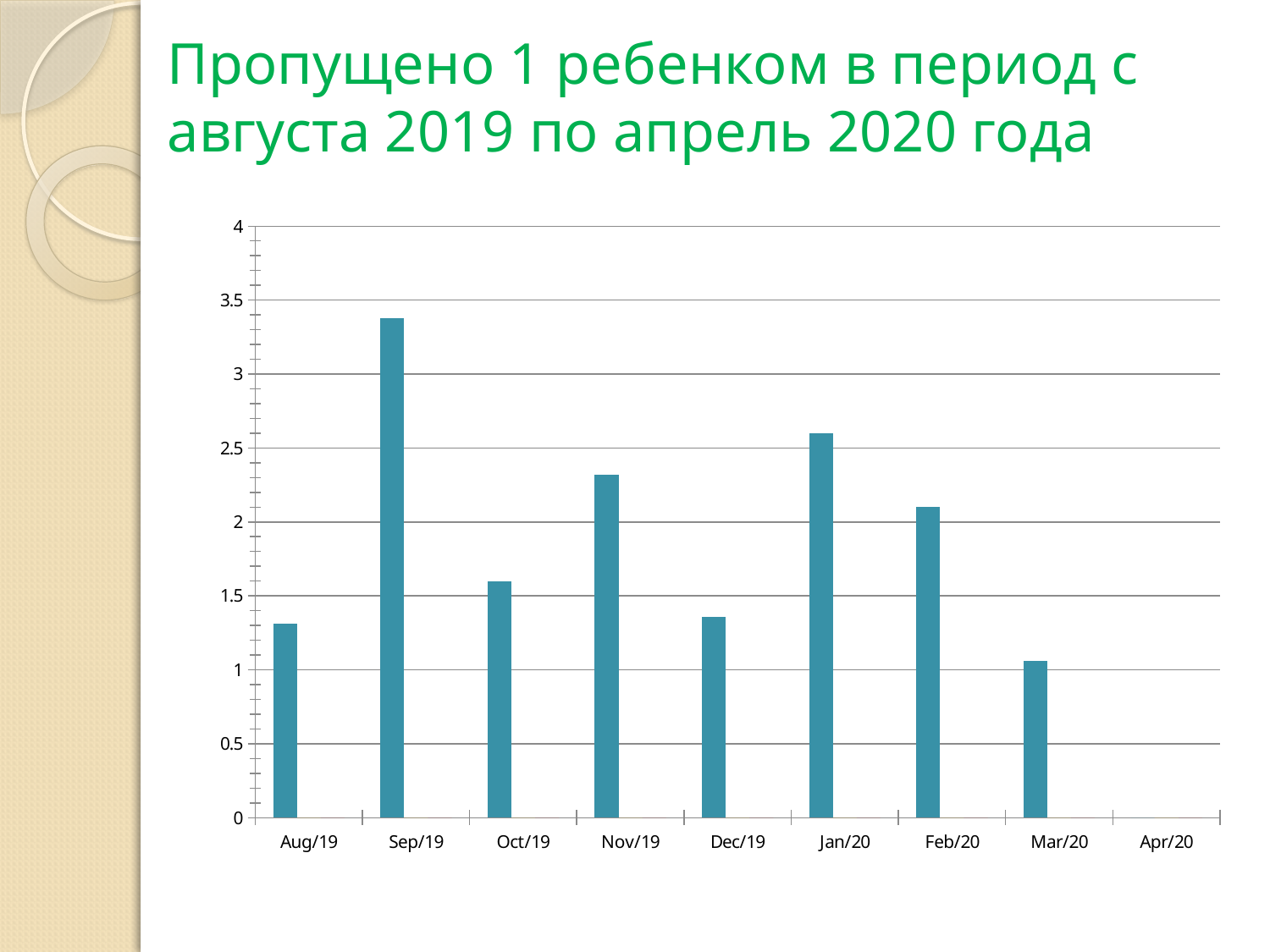
Which is larger, the value for Nov/19 or the value for Oct/19? Nov/19 Which is larger, the value for Sep/19 or the value for Jan/20? Sep/19 Is the value for Nov/19 greater or less than 2? greater What kind of chart is shown on the slide? bar chart How many months are listed along the x axis of the chart? 9 Is the value for Dec/19 greater or less than 1.5? less Is the value for Sep/19 greater or less than 3? greater Which month has the tallest bar in the chart? Sep/19 What is the highest value shown on the vertical axis of the chart? 4 Does the value rise or fall from Aug/19 to Sep/19? rise